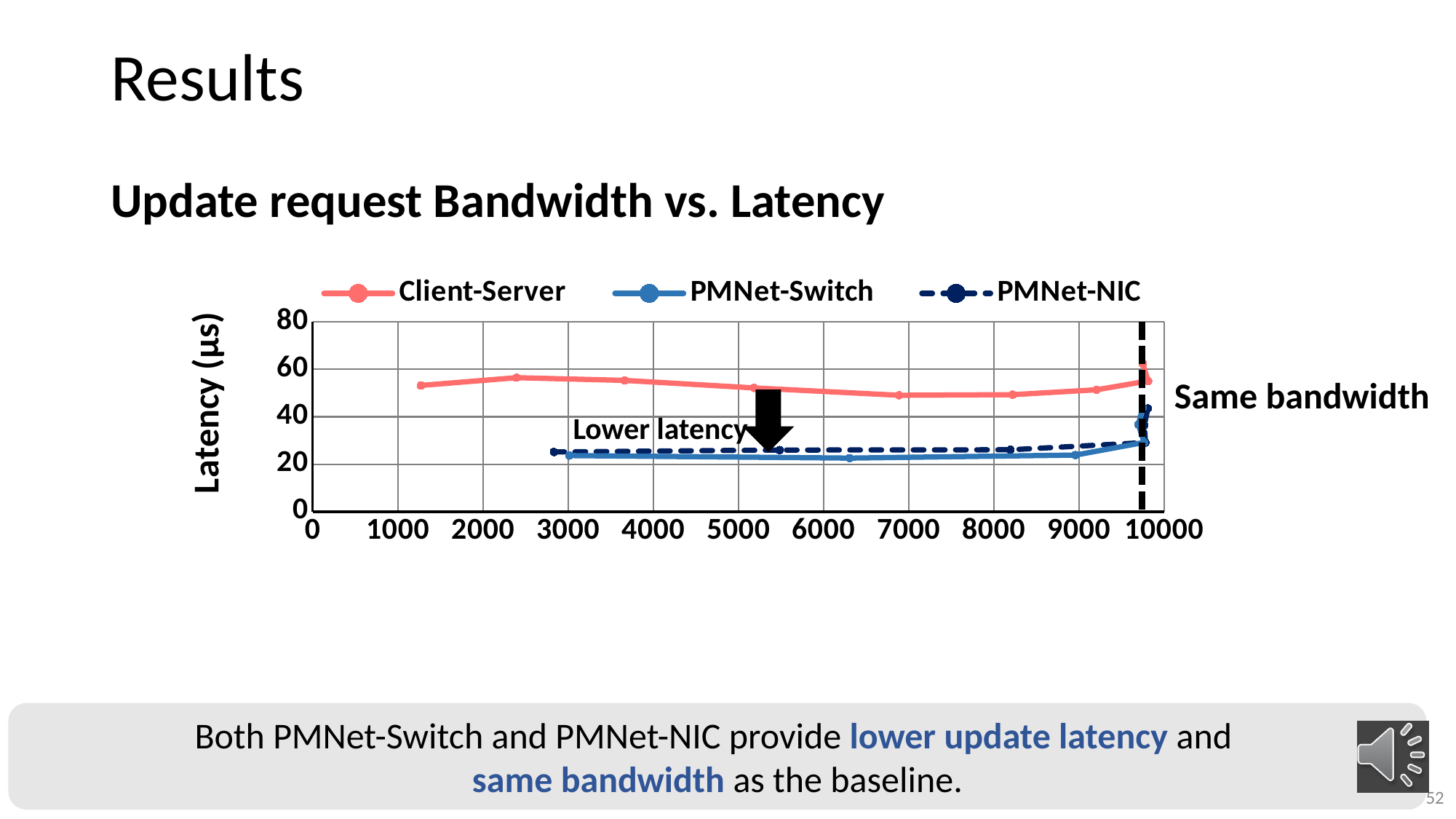
Is the Client-Server latency at a bandwidth of about 7000 greater or less than 60? less Is the PMNet-Switch latency at a bandwidth of about 4000 greater or less than 60? less Which series is drawn with a dashed line? PMNet-NIC How many series does the legend list? 3 Is the Client-Server latency at a bandwidth of about 2000 greater or less than 40? greater At a bandwidth of about 8000, which series has the lower latency, Client-Server or PMNet-NIC? PMNet-NIC Which series has the highest latency across the plotted bandwidth range? Client-Server What kind of chart is shown on the slide? line chart At a bandwidth of about 5000, which series has the higher latency, Client-Server or PMNet-Switch? Client-Server What is the label of the y axis? Latency (µs)